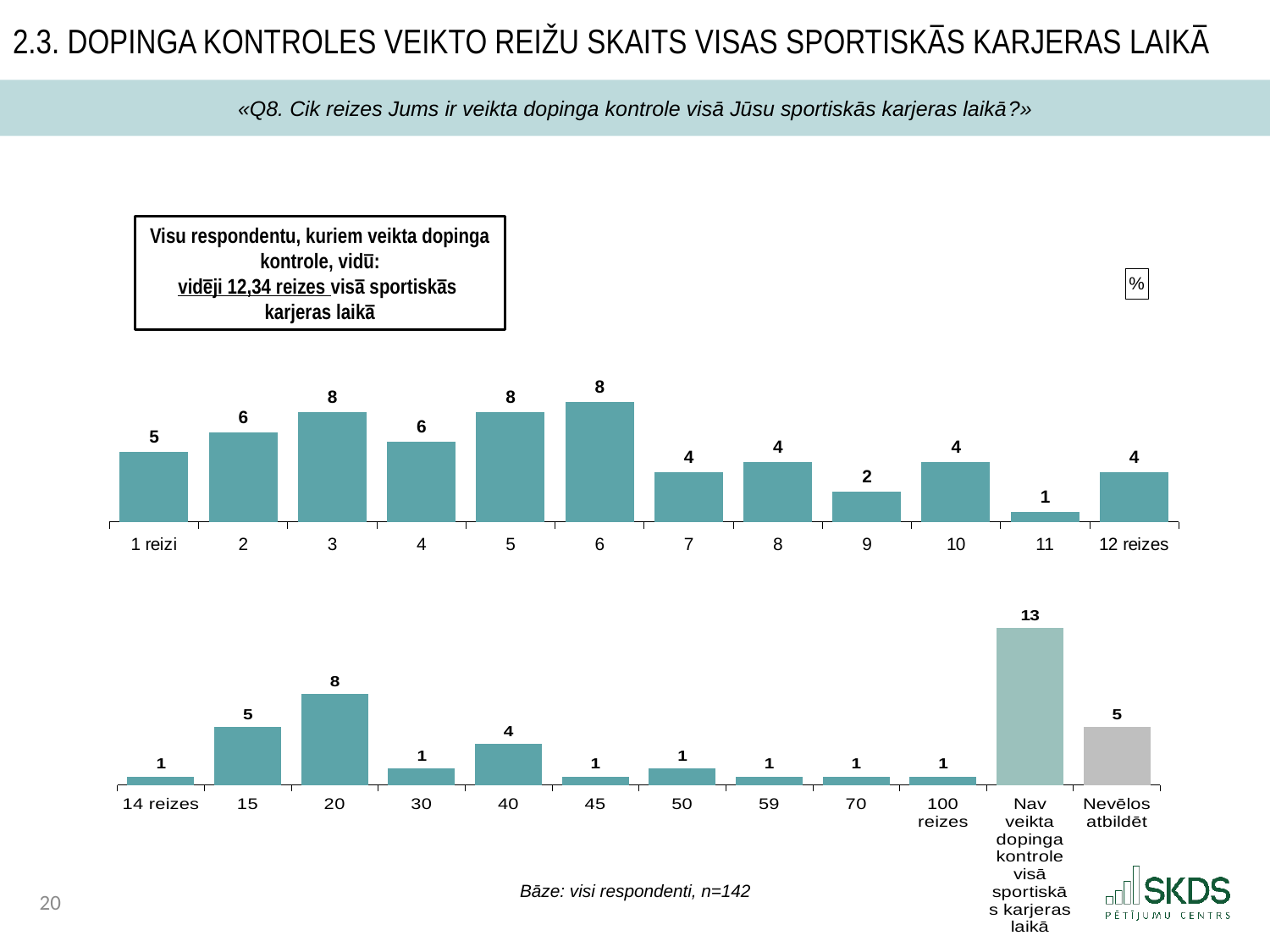
In the top chart, what is the difference between the values for "3" and "7"? 4 How many categories are shown in the bottom chart? 12 In the bottom chart, what is the difference between the values for "15" and "40"? 1 In the top chart, which category has the lowest value? 11 What type of chart is the top chart? Bar chart In the top chart, what is the value for "9"? 2 In the top chart, what is the value for "1 reizi"? 5 In the top chart, which is larger, the value for "2" or the value for "11"? 2 In the bottom chart, what is the value for "20"? 8 In the bottom chart, which category has the highest value? Nav veikta dopinga kontrole visā sportiskās karjeras laikā How many categories are shown in the top chart? 12 In the bottom chart, what is the value for "Nevēlos atbildēt"? 5